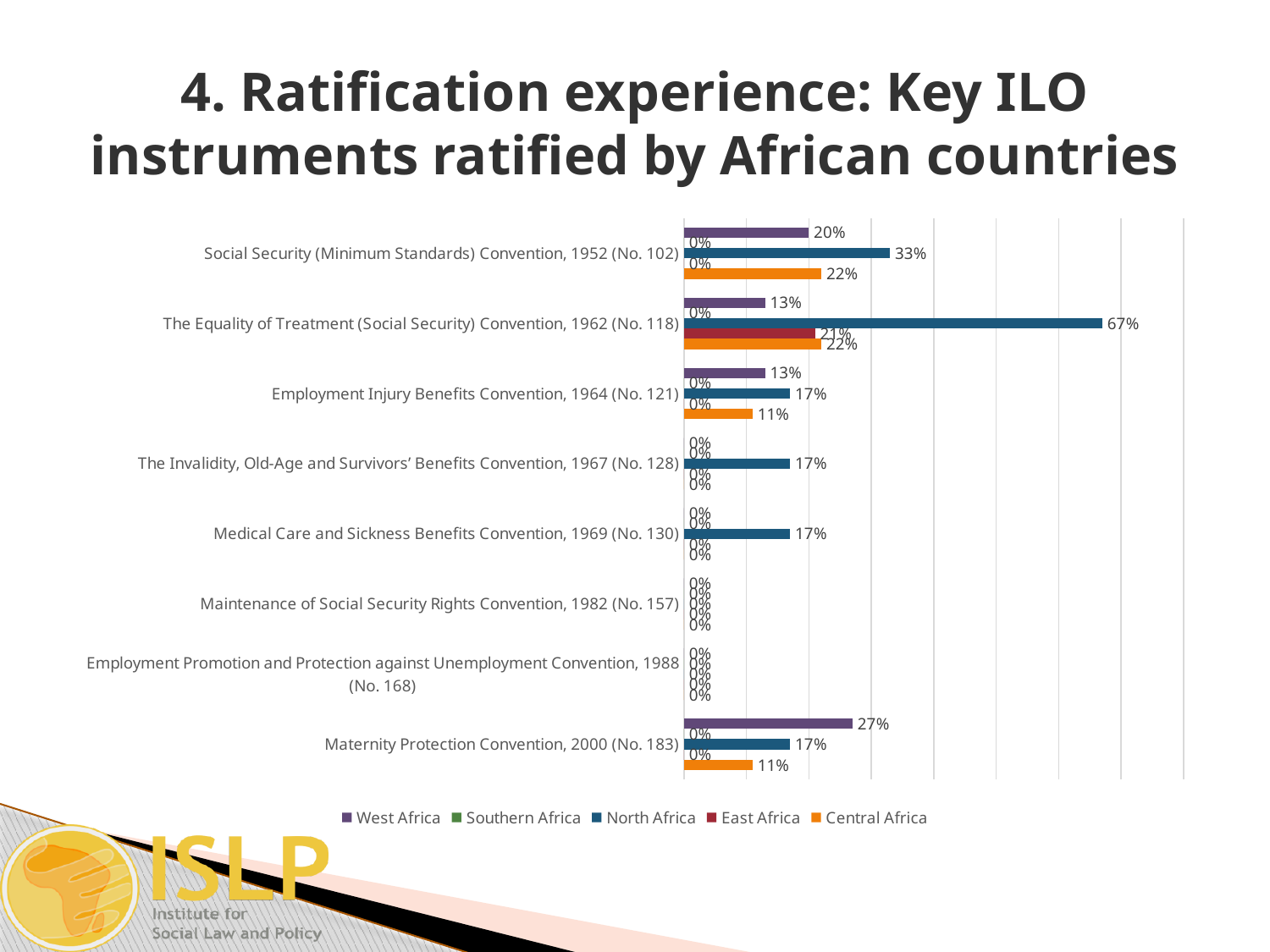
How many ILO conventions (categories) are plotted on the chart? 8 What kind of chart is shown on the slide? Bar chart How many series does the legend list? 5 Which series is shown in orange in the legend? Central Africa What is the value for East Africa for the Equality of Treatment (Social Security) Convention, 1962 (No. 118)? 21% What is the difference between the North Africa and West Africa values for the Social Security (Minimum Standards) Convention, 1952 (No. 102)? 13% What is the value for Southern Africa for the Maternity Protection Convention, 2000 (No. 183)? 0% What is the value for North Africa for the Equality of Treatment (Social Security) Convention, 1962 (No. 118)? 67% What is the value for Central Africa for the Social Security (Minimum Standards) Convention, 1952 (No. 102)? 22% For the Employment Injury Benefits Convention, 1964 (No. 121), which is larger: the North Africa value or the Central Africa value? North Africa What is the value for West Africa for the Maternity Protection Convention, 2000 (No. 183)? 27% Which convention has the highest North Africa value? The Equality of Treatment (Social Security) Convention, 1962 (No. 118)